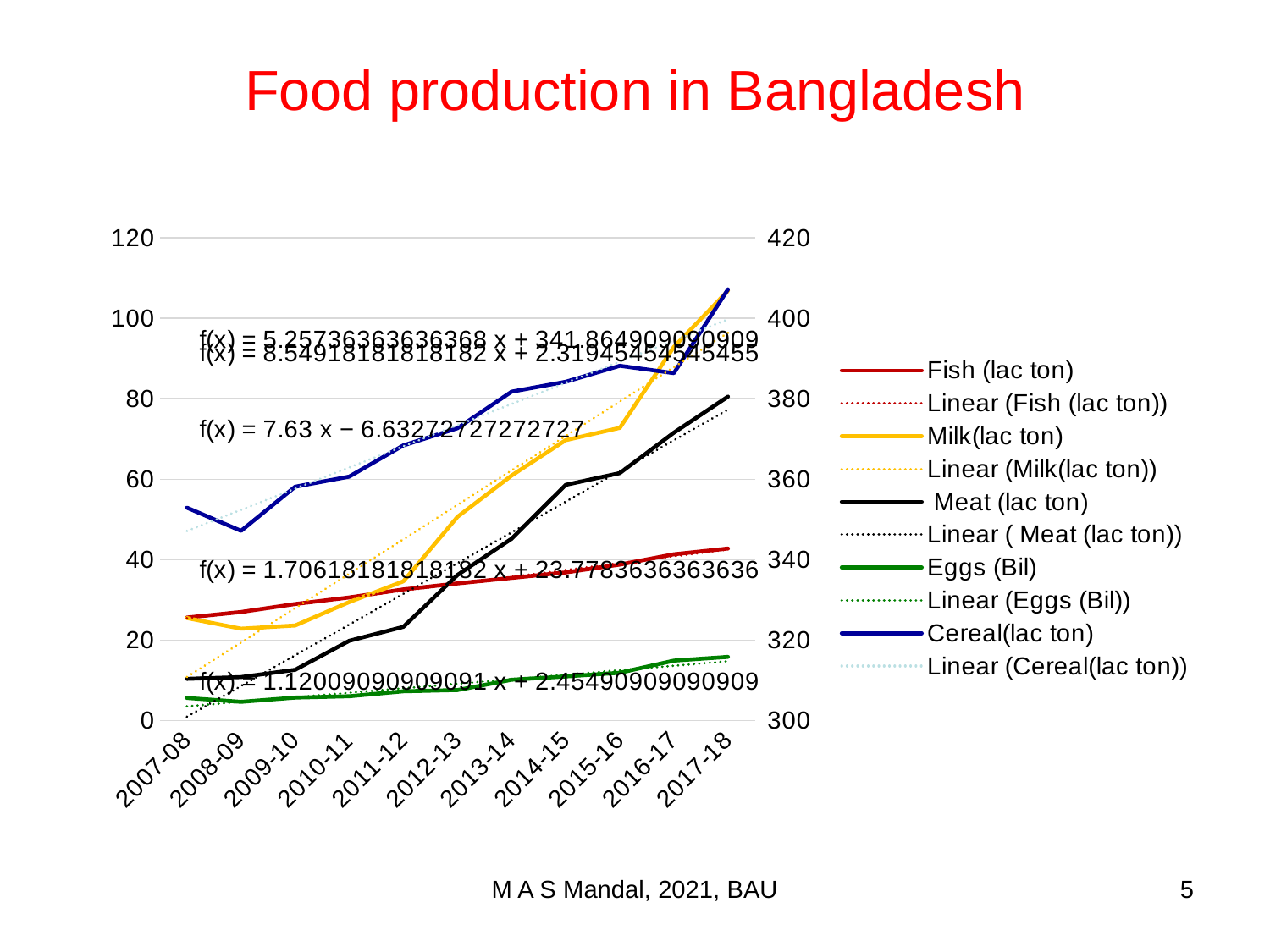
In 2017-18, which is higher, Milk (lac ton) or Fish (lac ton)? Milk (lac ton) What is the title of the chart? Food production in Bangladesh In 2017-18, which is higher, Meat (lac ton) or Eggs (Bil)? Meat (lac ton) How many entries does the legend list? 10 Is the value for Eggs (Bil) in 2017-18 greater or less than 20 on the left axis? less Is the value for Fish (lac ton) in 2017-18 greater or less than 40 on the left axis? greater Is the value for Milk (lac ton) in 2017-18 greater or less than 100 on the left axis? greater How many years (categories) are shown along the x axis? 11 Does the Milk (lac ton) line generally rise or fall from 2007-08 to 2017-18? rise Which colour is used for the Milk (lac ton) line? yellow What kind of chart is shown on the slide? line chart